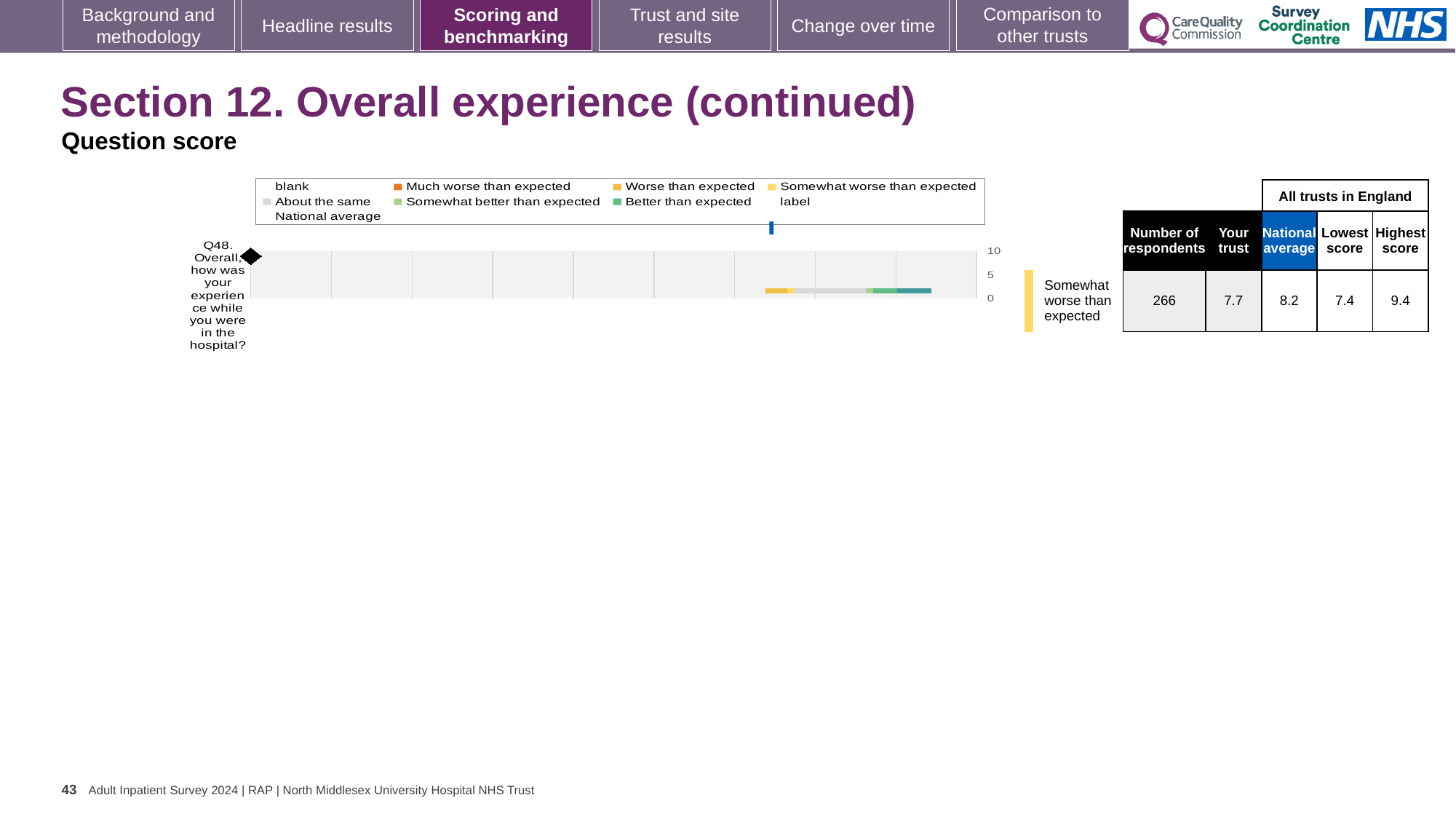
How many respondents answered Q48? 266 What is the national average score for Q48? 8.2 What kind of chart is shown on the slide? bar chart What is the 'Your trust' score for Q48? 7.7 How many survey questions are plotted in the chart? 1 What is the lowest score among all trusts in England for Q48? 7.4 What is the difference between the national average and the 'Your trust' score for Q48? 0.5 Which is larger for Q48, the 'Your trust' score or the national average? National average Is the 'Your trust' score for Q48 greater or less than 5? greater Which survey question is plotted in the chart? Q48. Overall, how was your experience while you were in the hospital? What is the highest tick value shown on the chart's score axis? 10 What is the highest score among all trusts in England for Q48? 9.4